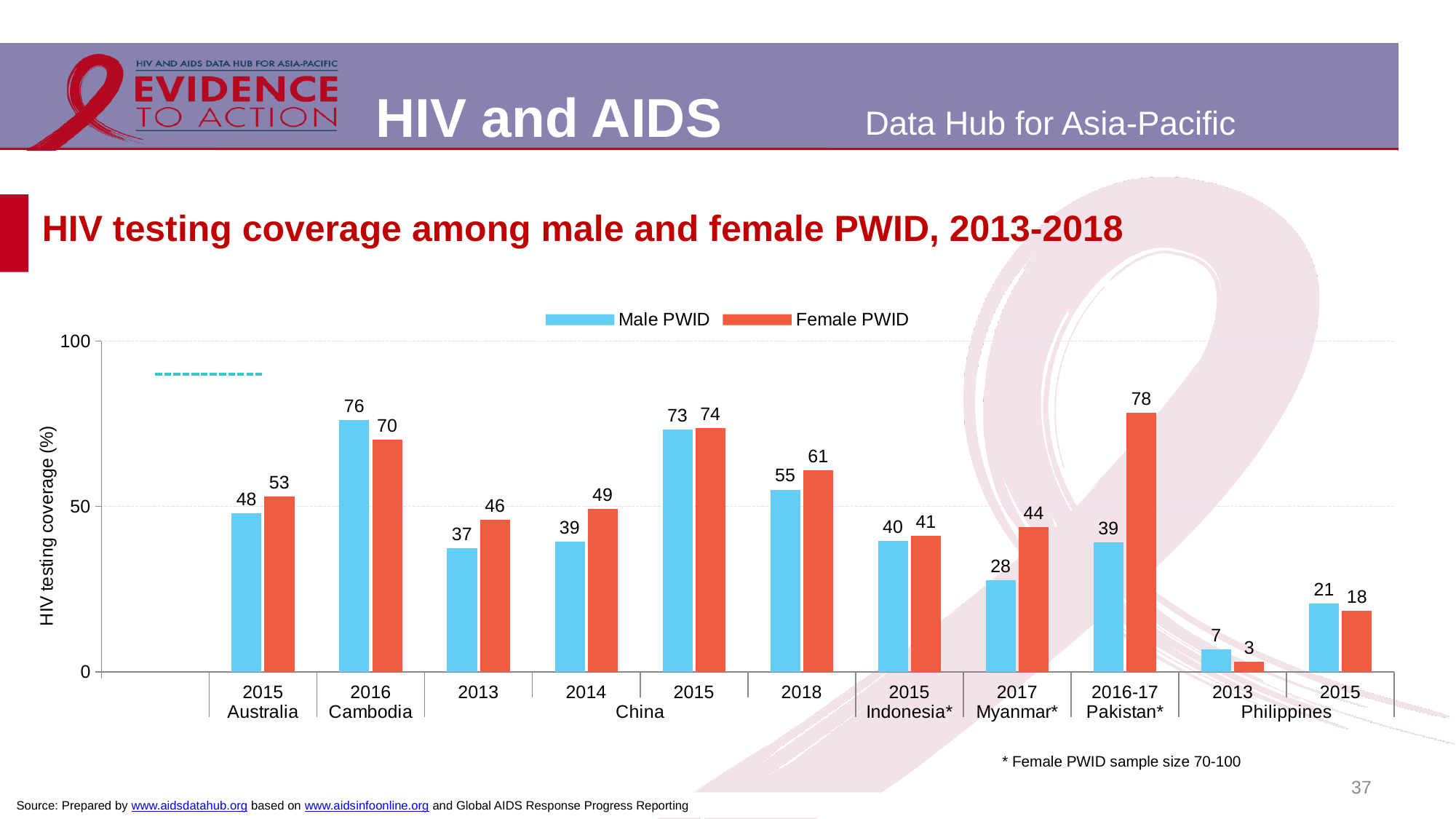
Which country-year group has the lowest Male PWID value? Philippines 2013 How many country-year groups are shown on the x axis? 11 What is the difference between the Female PWID and Male PWID values for Pakistan in 2016-17? 39 What is the HIV testing coverage for Female PWID in Pakistan in 2016-17? 78 Which is larger for the Philippines in 2015: the Male PWID value or the Female PWID value? Male PWID How many series does the legend list? 2 What is the HIV testing coverage for Male PWID in Australia in 2015? 48 Which country-year group has the highest Female PWID value? Pakistan 2016-17 What is the HIV testing coverage for Female PWID in China in 2018? 61 What kind of chart is shown on the slide? Bar chart What is the difference between the Male PWID and Female PWID values for Cambodia in 2016? 6 Which is larger for Myanmar in 2017: the Male PWID value or the Female PWID value? Female PWID